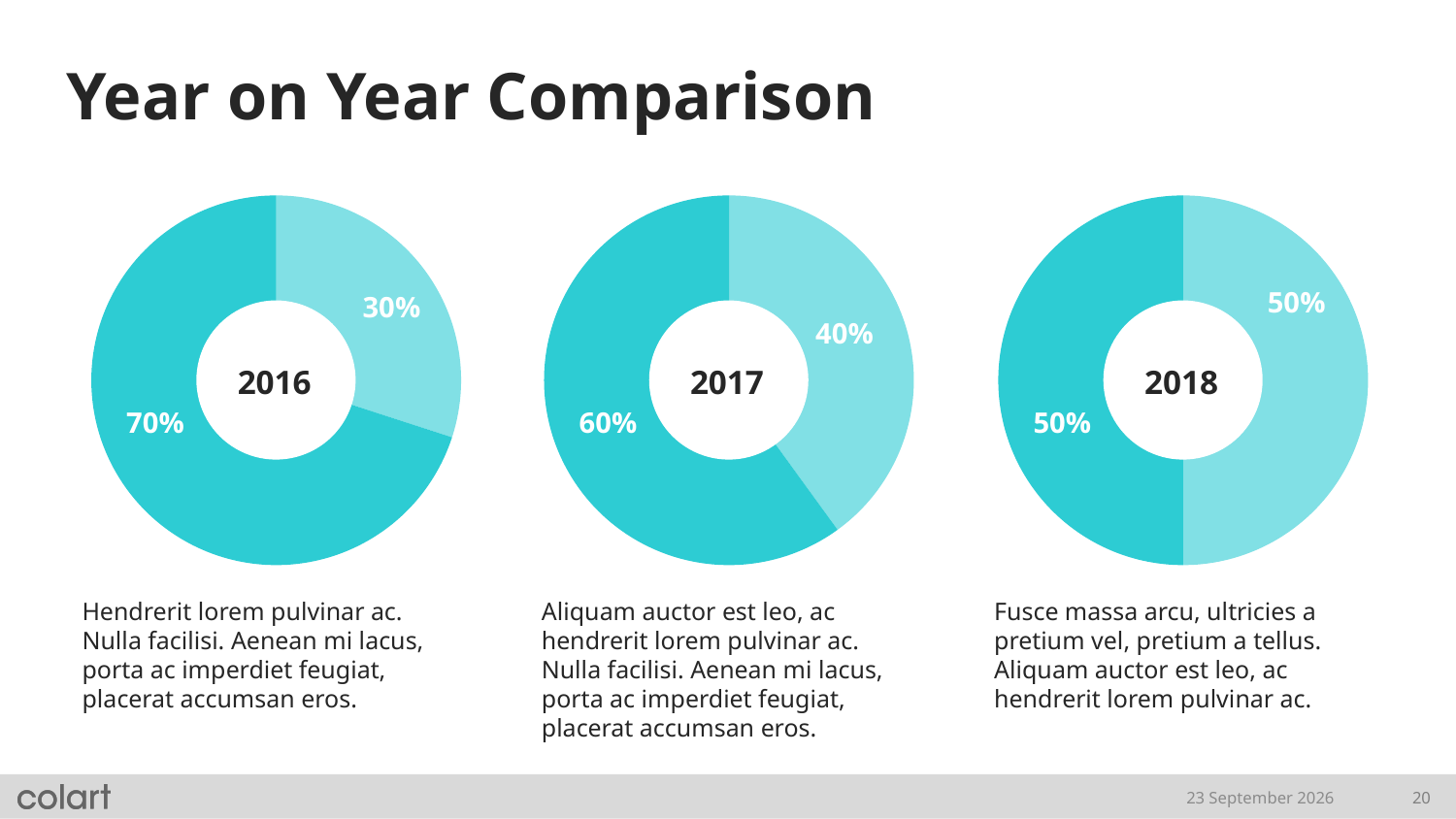
In the 2017 chart, what value is shown for the darker teal slice? 60% In the 2017 chart, what is the difference between the two slice values? 20% In the 2017 chart, which slice is larger, the darker teal one or the lighter one? The darker teal one In the 2016 chart, what value is shown for the smaller, lighter slice? 30% In the 2018 chart, what value is shown for each of the two slices? 50% What kind of chart is used for the 2016 chart? Donut chart How many donut charts are shown on the slide? 3 How many slices does the 2018 chart have? 2 In the 2016 chart, what is the difference between the two slice values? 40% In the 2017 chart, what value is shown for the lighter slice? 40% Across the three charts, does the darker teal slice's value rise or fall from 2016 to 2018? Fall In the 2016 chart, what value is shown for the larger, darker teal slice? 70%